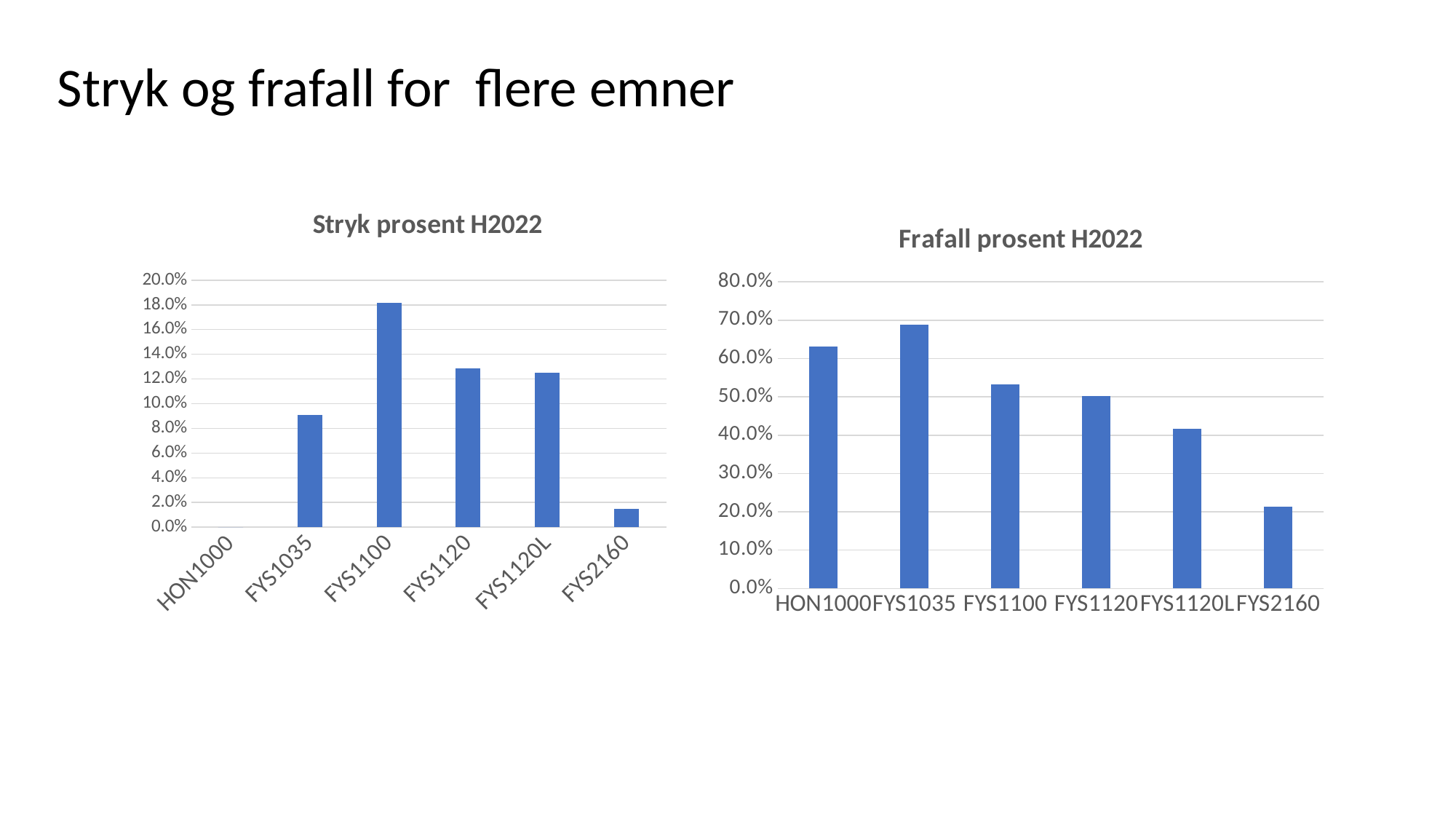
In the "Frafall prosent H2022" chart, which course has the lowest value? FYS2160 In the "Stryk prosent H2022" chart, what is the value for HON1000? 0.0% In the "Stryk prosent H2022" chart, is the value for FYS1035 greater or less than 8.0%? greater In the "Frafall prosent H2022" chart, which course has the highest value? FYS1035 In the "Frafall prosent H2022" chart, is the value for FYS1100 larger than the value for FYS1120L? yes In the "Frafall prosent H2022" chart, is the value for HON1000 greater or less than 60.0%? greater What type of chart is the "Stryk prosent H2022" chart? bar chart In the "Stryk prosent H2022" chart, which course has the highest value? FYS1100 How many courses are shown on the x axis of the "Frafall prosent H2022" chart? 6 In the "Stryk prosent H2022" chart, is the value for FYS1100 greater or less than 16.0%? greater In the "Stryk prosent H2022" chart, which course has the lowest value? HON1000